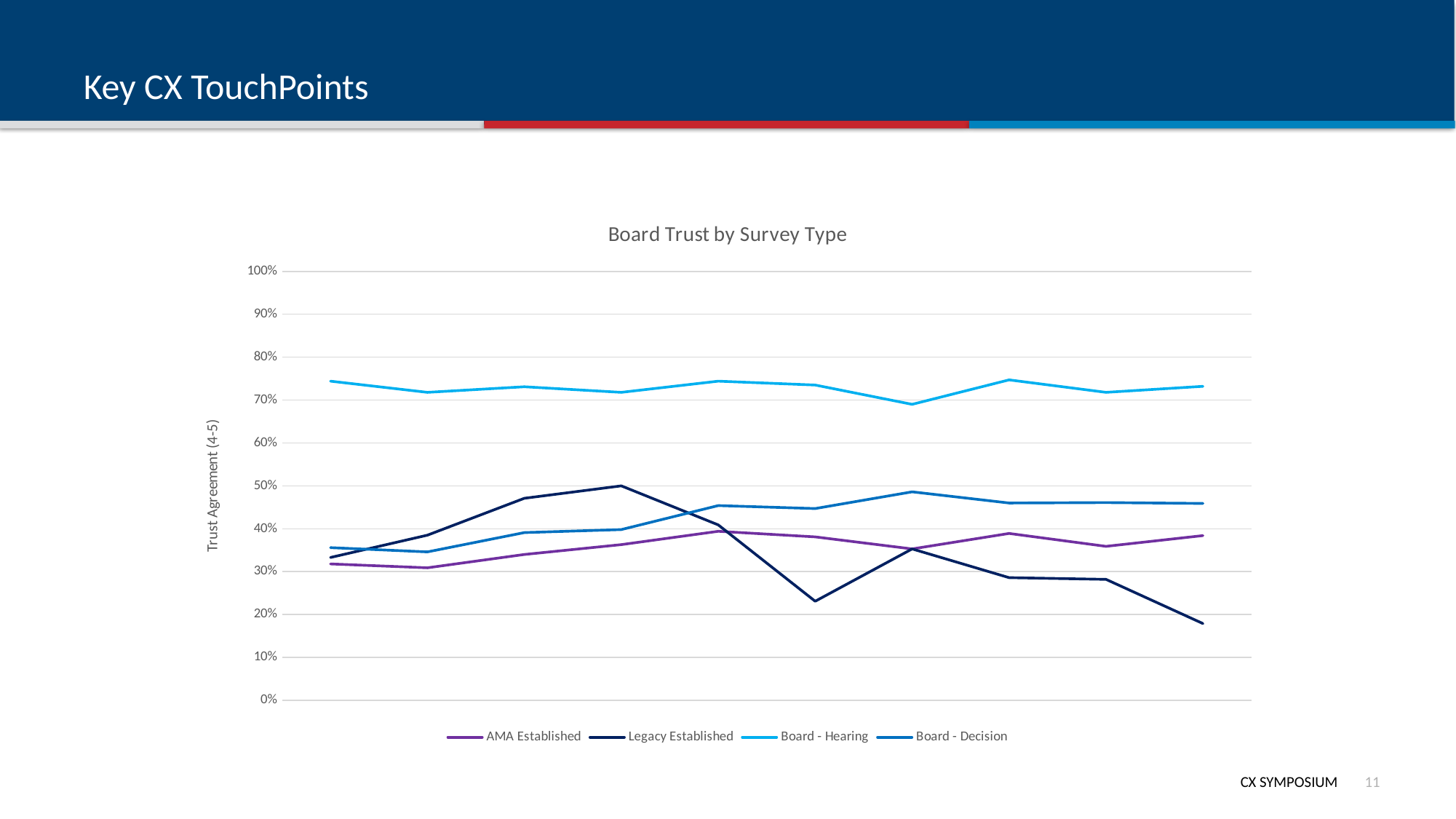
Is the highest value for AMA Established greater or less than 50%? less Does the Legacy Established line rise or fall from its first point to its last point? fall Is the lowest value for Legacy Established greater or less than 20%? less Which series has the highest values across the whole chart? Board - Hearing How many series does the legend list? 4 What is the label on the vertical axis? Trust Agreement (4-5) What kind of chart is shown on the slide? line chart Which series reaches the lowest value on the chart? Legacy Established How many data points does each series have? 10 At the last point on the x axis, which is higher, Board - Decision or Legacy Established? Board - Decision What is the title of the chart? Board Trust by Survey Type Is the lowest value for Board - Hearing greater or less than 60%? greater